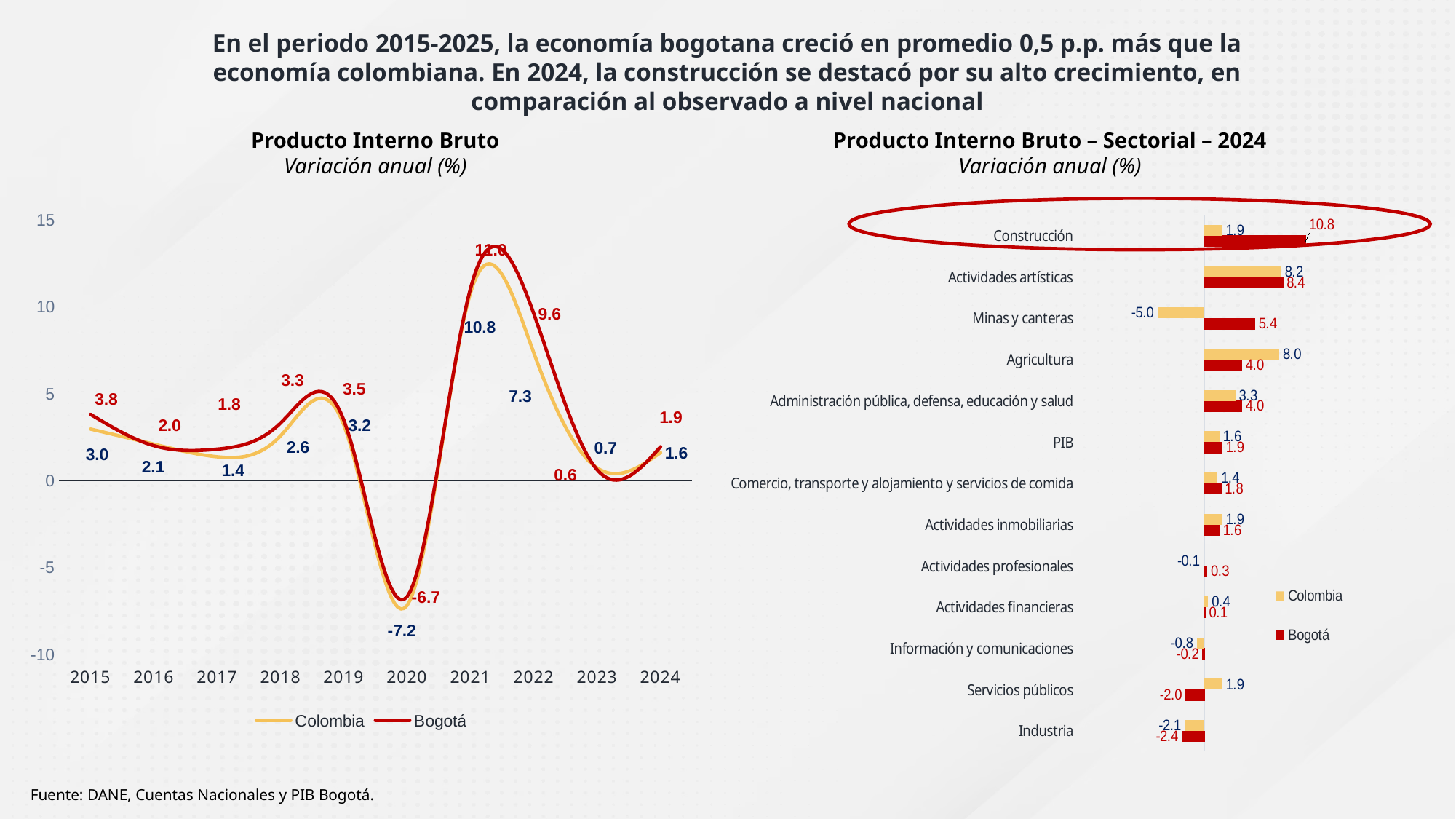
In the 'Producto Interno Bruto – Sectorial – 2024' chart, which is larger for Agricultura, Colombia or Bogotá? Colombia What type of chart is 'Producto Interno Bruto – Sectorial – 2024'? bar chart In the 'Producto Interno Bruto – Sectorial – 2024' chart, which sector has the highest value for Bogotá? Construcción In the 'Producto Interno Bruto' line chart, what was the annual variation for Bogotá in 2020? -6.7 In the 'Producto Interno Bruto' line chart, how many years are shown on the x axis? 10 In the 'Producto Interno Bruto' line chart, what is the difference between Bogotá and Colombia in 2022? 2.3 In the 'Producto Interno Bruto – Sectorial – 2024' chart, how many sectors (categories) are listed? 13 In the 'Producto Interno Bruto – Sectorial – 2024' chart, what is the value for Colombia in Minas y canteras? -5.0 In the 'Producto Interno Bruto' line chart, which year shows the lowest value for Colombia? 2020 In the 'Producto Interno Bruto' line chart, did the Bogotá value rise or fall from 2022 to 2023? fall In the 'Producto Interno Bruto – Sectorial – 2024' chart, what is the value for Bogotá in Construcción? 10.8 In the 'Producto Interno Bruto' line chart, what was the annual variation for Colombia in 2022? 7.3